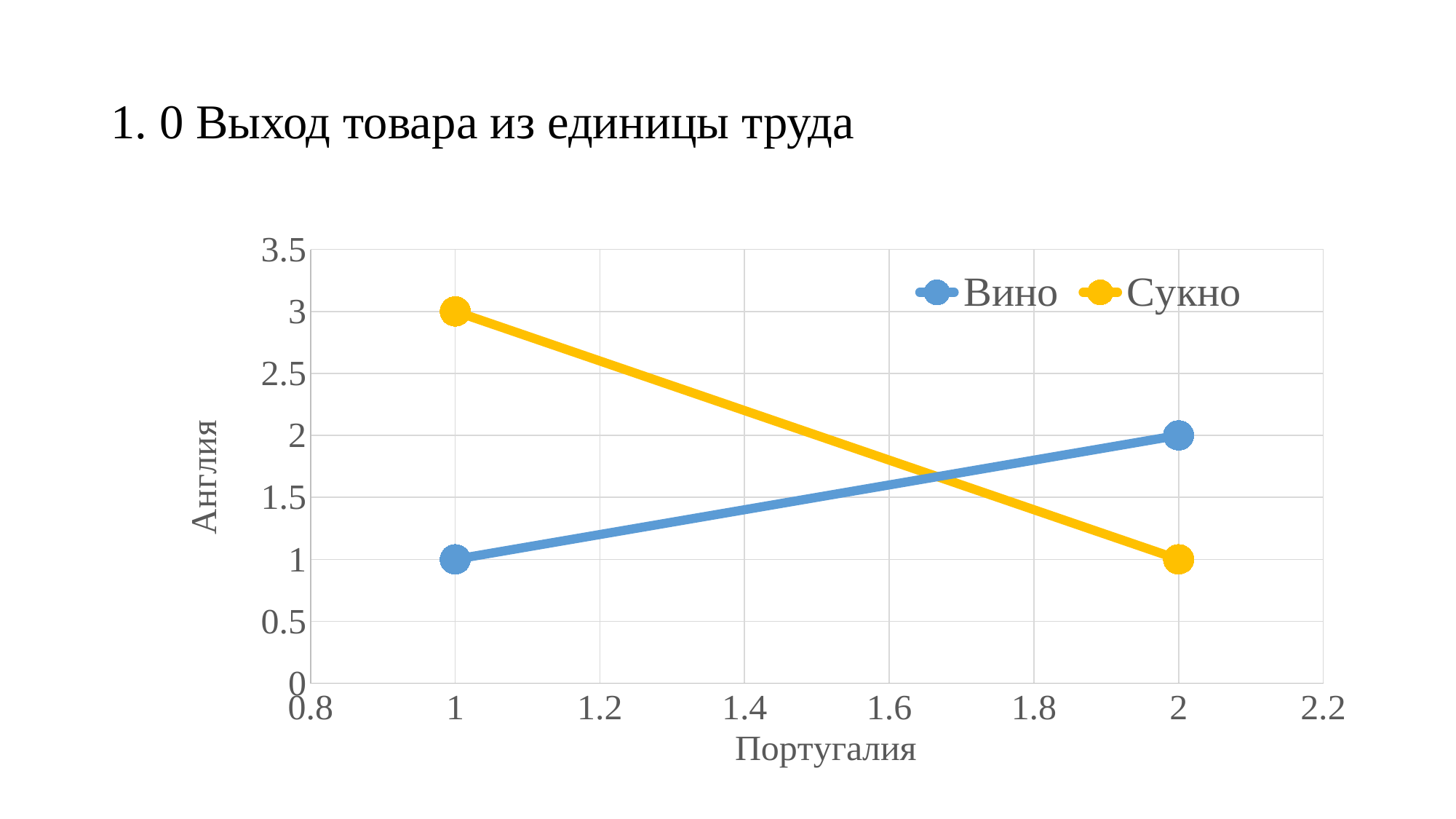
Which series reaches the highest Англия value on the chart? Сукно At Португалия = 1, what is the difference between the Сукно value and the Вино value? 2 What is the Англия value for Сукно when Португалия is 2? 1 Does the Сукно line rise or fall as Португалия increases from 1 to 2? fall Does the Вино line rise or fall as Португалия increases from 1 to 2? rise At Португалия = 1, which series has the higher Англия value, Вино or Сукно? Сукно What are the names of the two series in the legend? Вино and Сукно How many series does the legend list? 2 What is the label of the horizontal axis? Португалия What is the Англия value for Вино when Португалия is 1? 1 What is the Англия value for Сукно when Португалия is 1? 3 What is the Англия value for Вино when Португалия is 2? 2